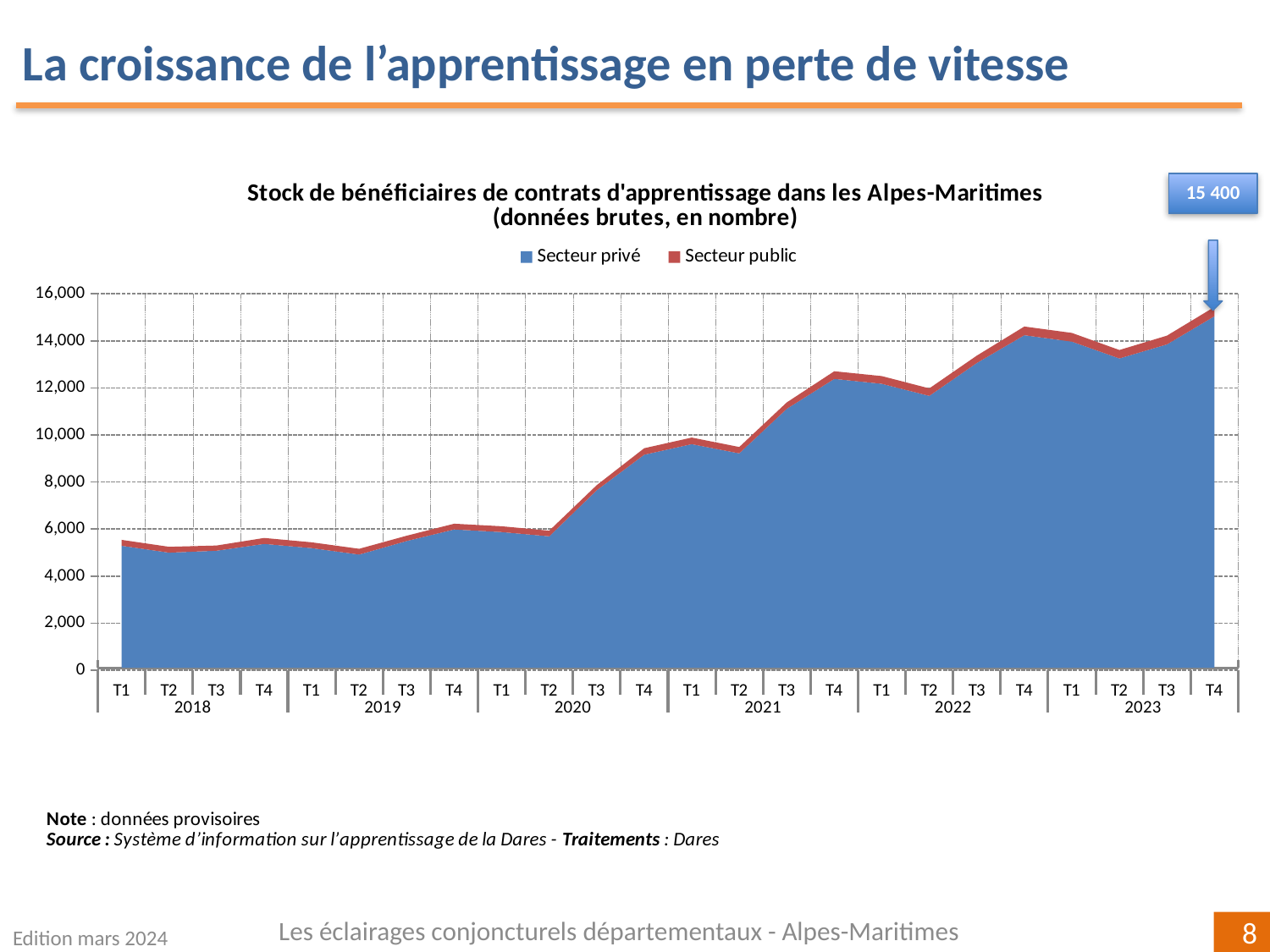
What is the total stock of apprenticeship beneficiaries shown for T4 2023? 15 400 How many quarterly data points are plotted on the x axis? 24 Is the total value for T1 2022 greater or less than 12,000? greater Is the total value for T4 2020 greater or less than 10,000? less Which quarter has the highest total stock of beneficiaries? T4 2023 What type of chart is shown on the slide? Area chart Overall, do the values rise or fall from 2018 to 2023? rise Which is larger, the total for T4 2022 or the total for T2 2023? T4 2022 Is the total value for T4 2022 greater or less than 14,000? greater How many series does the legend list? 2 What are the two series named in the legend? Secteur privé and Secteur public